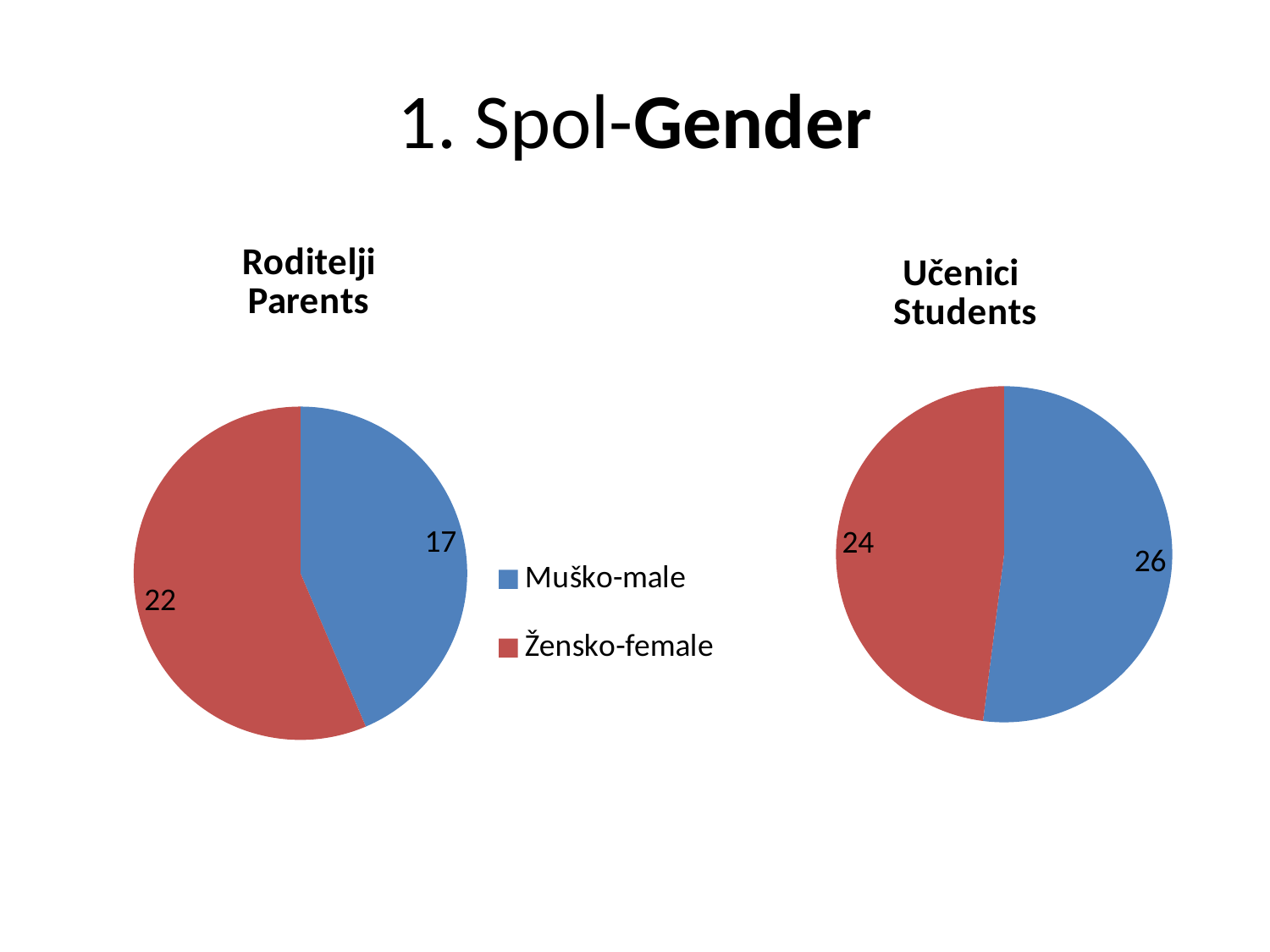
Which colour represents Žensko-female in the charts? Red In the Učenici Students chart, which category has the smallest slice? Žensko-female In the Učenici Students chart, is the value for Muško-male larger or smaller than the value for Žensko-female? larger In the Učenici Students chart, what share of the pie does Muško-male represent? 52% In the Učenici Students chart, what is the value for Muško-male? 26 What type of chart is used for the Roditelji Parents data? Pie chart In the Roditelji Parents chart, what is the value for Muško-male? 17 How many categories does the legend list? 2 In the Roditelji Parents chart, which category has the largest slice? Žensko-female In the Učenici Students chart, what is the value for Žensko-female? 24 In the Roditelji Parents chart, what is the difference between the Žensko-female and Muško-male values? 5 In the Roditelji Parents chart, what is the value for Žensko-female? 22